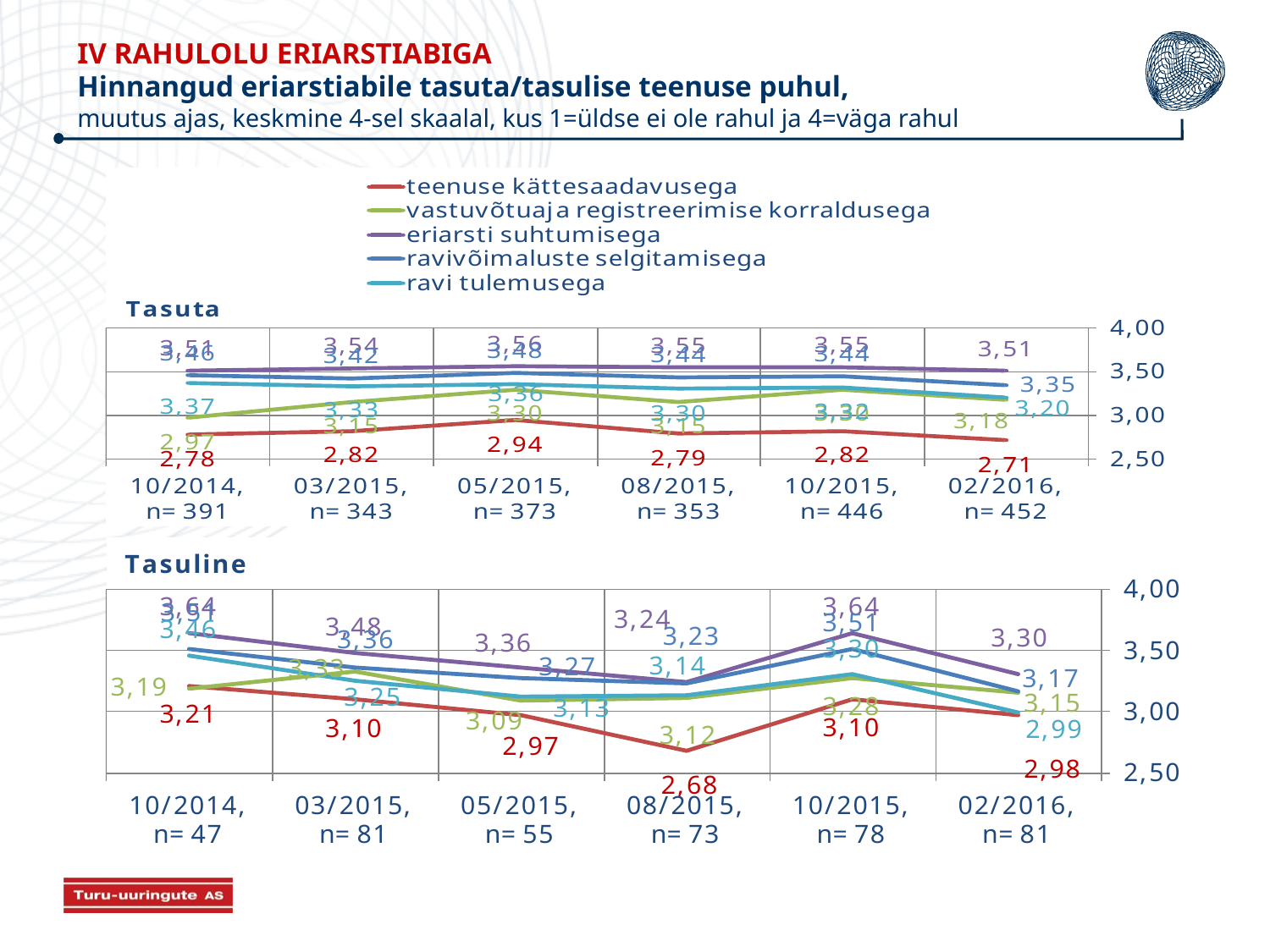
In the Tasuta chart, what is the value for teenuse kättesaadavusega at 02/2016? 2,71 In the Tasuline chart, what is the value for teenuse kättesaadavusega at 08/2015? 2,68 In the Tasuline chart, what is the difference between teenuse kättesaadavusega at 10/2014 (3,21) and at 08/2015 (2,68)? 0,53 How many series does the legend list? 5 In the Tasuta chart, is the value for teenuse kättesaadavusega at 02/2016 greater or less than 3,00? less In the Tasuta chart, how many time points are plotted along the x axis? 6 In the Tasuta chart, at which time point is teenuse kättesaadavusega highest? 05/2015 In the Tasuline chart, at which time point is teenuse kättesaadavusega lowest? 08/2015 In the Tasuline chart, what is the value for eriarsti suhtumisega at 02/2016? 3,30 In the Tasuta chart, what is the value for teenuse kättesaadavusega at 05/2015? 2,94 In the Tasuta chart at 02/2016, which is larger: eriarsti suhtumisega or teenuse kättesaadavusega? eriarsti suhtumisega What type of chart is used for the Tasuta and Tasuline data on this slide? line chart